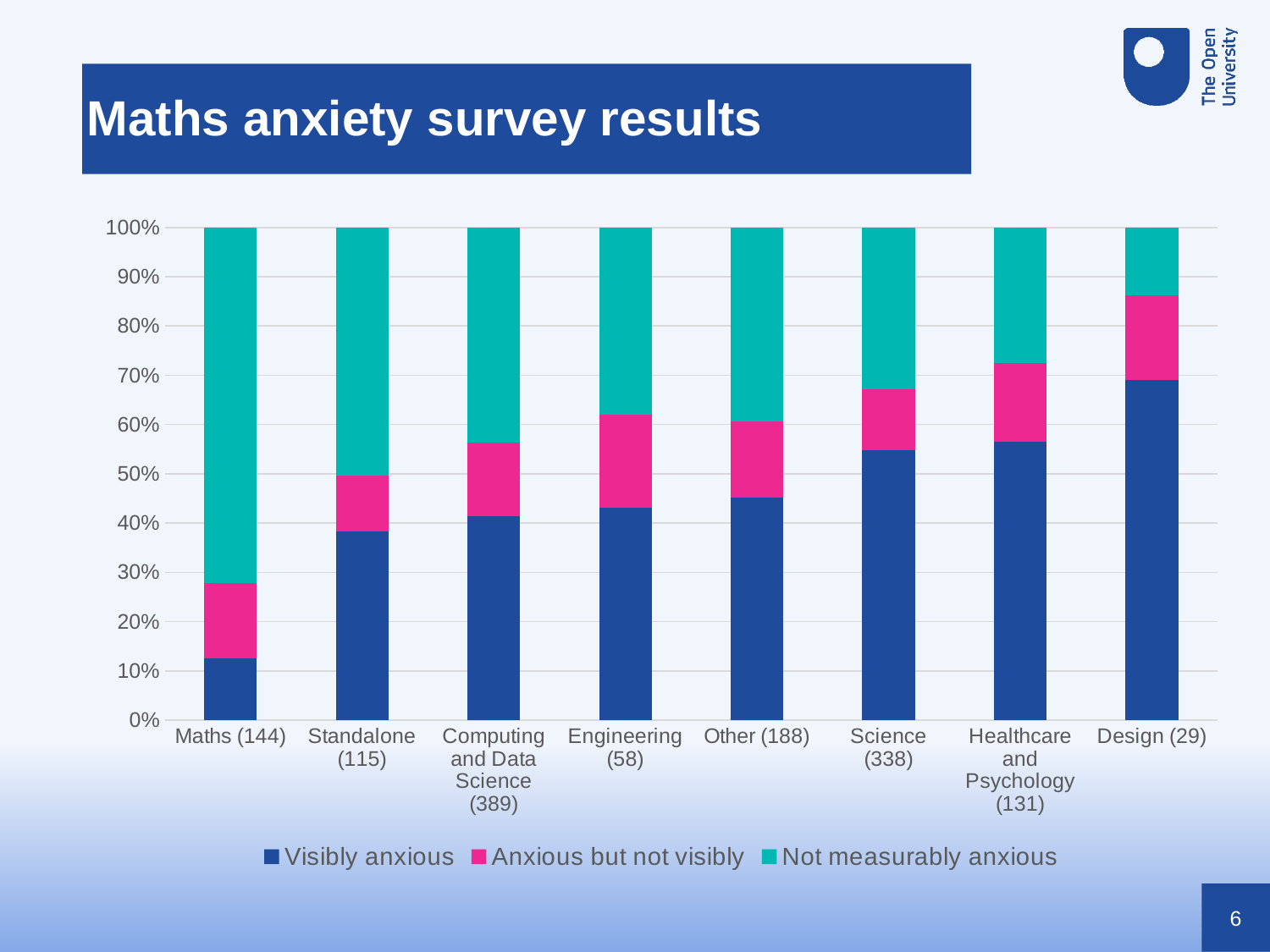
Is the Visibly anxious share for Design (29) greater or less than 60%? greater Which has a larger Visibly anxious share, Science (338) or Standalone (115)? Science (338) How many series does the chart's legend list? 3 Does the Visibly anxious share rise or fall moving from left to right across the categories? rise Which category has the largest share of Visibly anxious respondents? Design (29) How many categories are shown along the x axis of the chart? 8 Is the Visibly anxious share for Science (338) greater or less than 50%? greater What kind of chart is shown on the slide? Stacked bar chart What is the title of the chart on the slide? Maths anxiety survey results Is the Visibly anxious share for Maths (144) greater or less than 20%? less Which category has the smallest share of Visibly anxious respondents? Maths (144) Which category has the largest share of Not measurably anxious respondents? Maths (144)